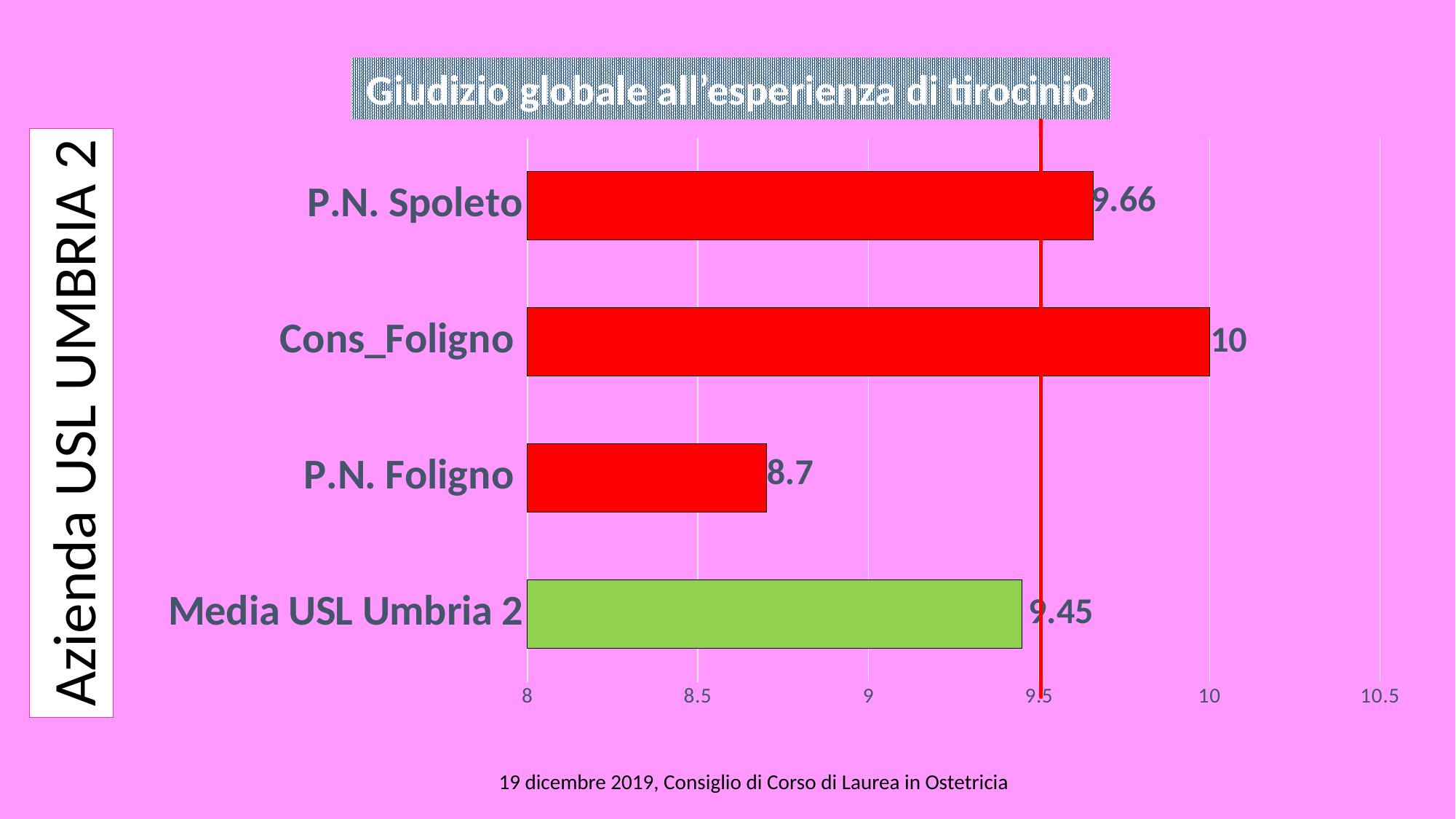
What is the value for P.N. Spoleto? 9.66 Which category has the highest value? Cons_Foligno What is the value for P.N. Foligno? 8.7 What is the difference between the values for Cons_Foligno and P.N. Foligno? 1.3 Which category has the lowest value? P.N. Foligno Is the value for P.N. Foligno greater or less than 9? less What is the difference between the values for P.N. Spoleto and Media USL Umbria 2? 0.21 What kind of chart is shown on the slide? bar chart Which is larger, the value for P.N. Spoleto or the value for Media USL Umbria 2? P.N. Spoleto What is the value for Cons_Foligno? 10 How many categories are shown in the chart? 4 What is the value for Media USL Umbria 2? 9.45